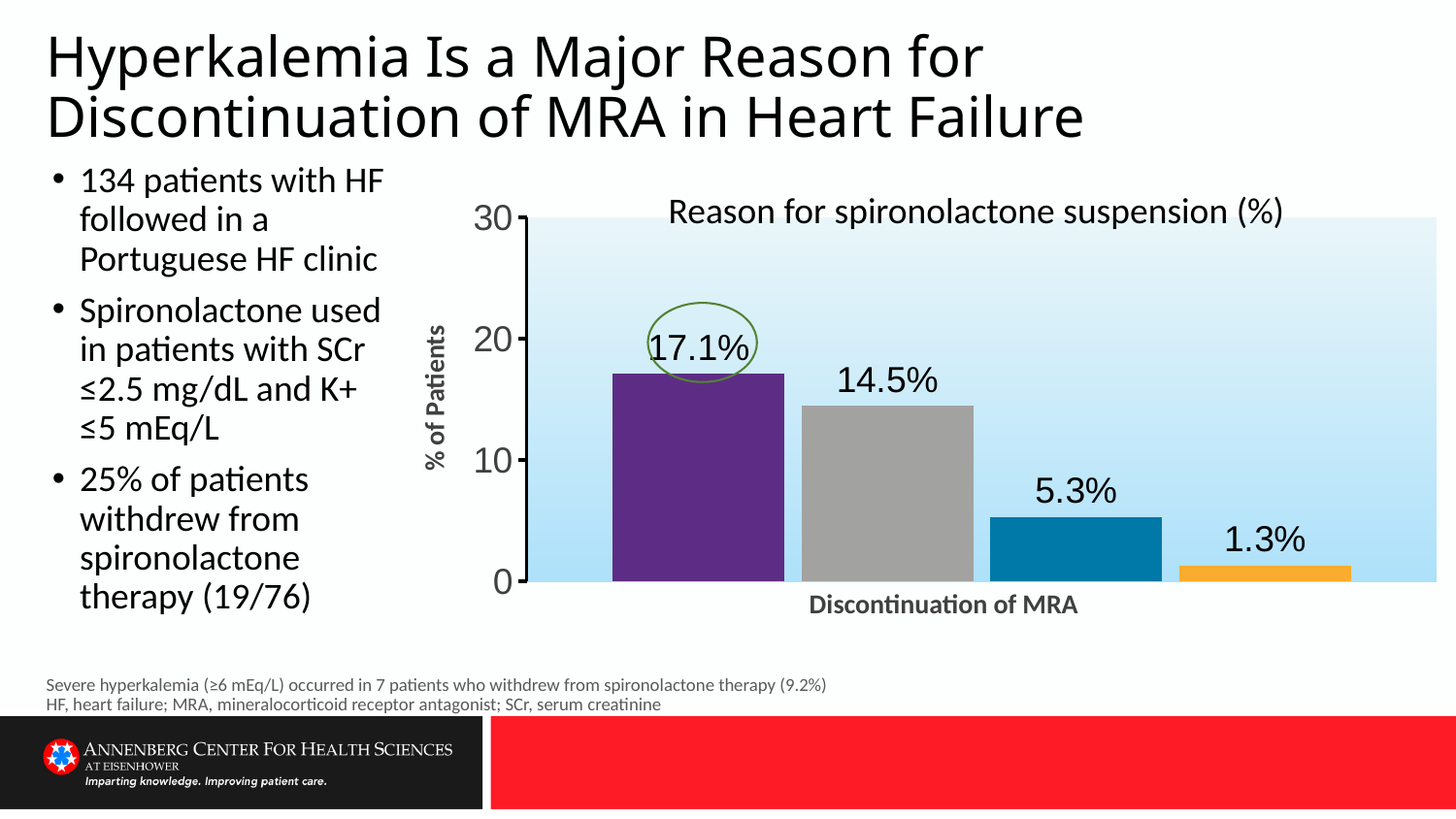
What is the lowest value shown in the chart? 1.3% What is the title of the chart? Reason for spironolactone suspension (%) What value is shown for the second (gray) bar in the chart? 14.5% What value is shown for the fourth (orange) bar in the chart? 1.3% Do the bar values rise or fall from left to right across the chart? fall What is the difference between the first bar (17.1%) and the second bar (14.5%)? 2.6% What value is shown for the third (blue) bar in the chart? 5.3% What is the highest value shown in the chart? 17.1% What type of chart is shown on the slide? bar chart How many bars are plotted in the chart? 4 What is the label on the y-axis of the chart? % of Patients What value is shown for the first (purple) bar in the chart? 17.1%